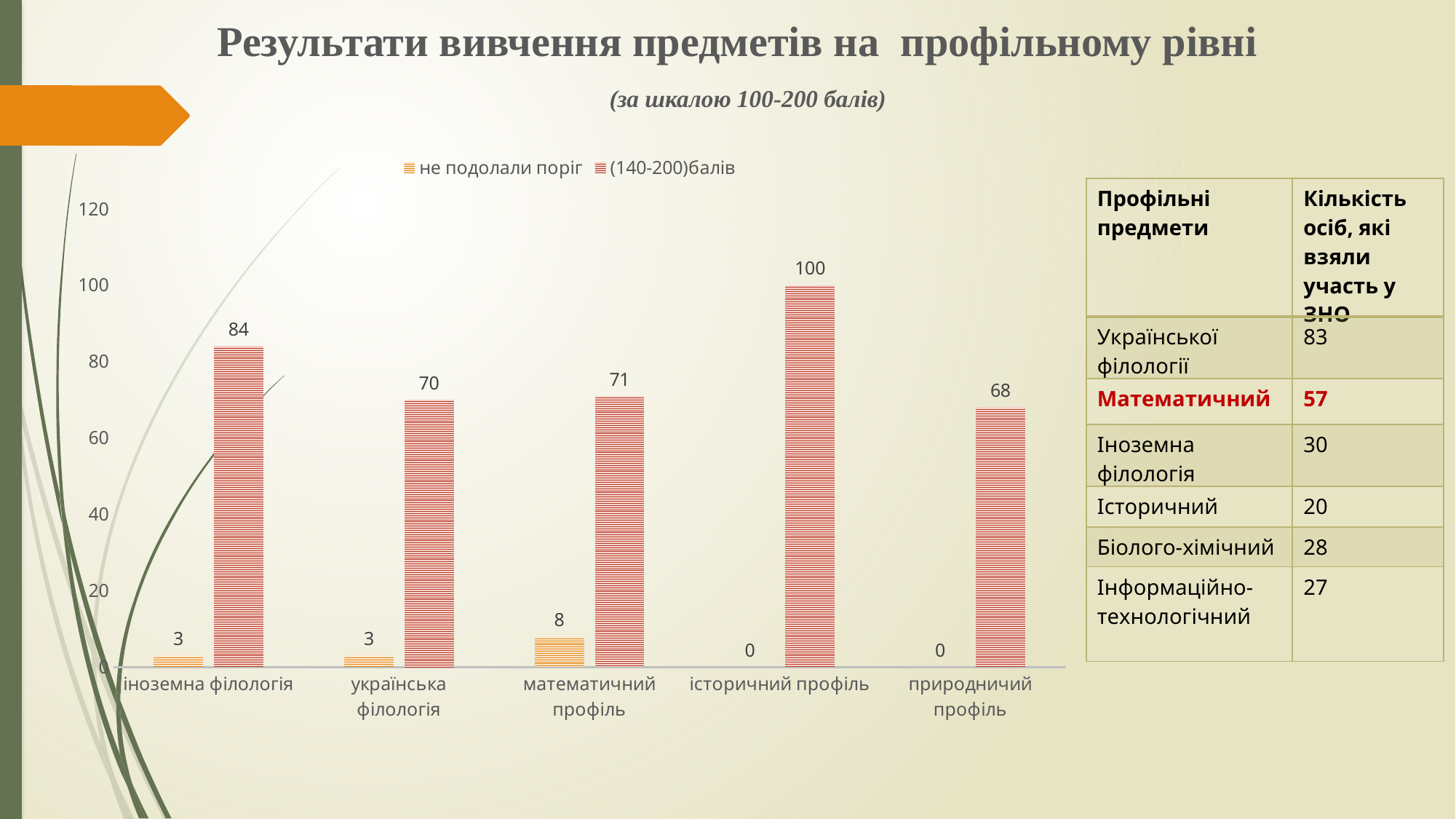
Which category has the lowest value in the "(140-200)балів" series? природничий профіль How many series does the chart legend list? 2 What is the value of the "не подолали поріг" series for "математичний профіль"? 8 What is the subtitle shown under the chart title? (за шкалою 100-200 балів) How many categories are shown on the x axis of the chart? 5 What is the value of the "(140-200)балів" series for "природничий профіль"? 68 What is the value of the "(140-200)балів" series for "історичний профіль"? 100 Which category has the highest value in the "не подолали поріг" series? математичний профіль What is the difference between the "(140-200)балів" values for "іноземна філологія" and "українська філологія"? 14 What kind of chart is shown on the slide? bar chart Which is larger: the "(140-200)балів" value for "іноземна філологія" or for "математичний профіль"? іноземна філологія Which category has the highest value in the "(140-200)балів" series? історичний профіль